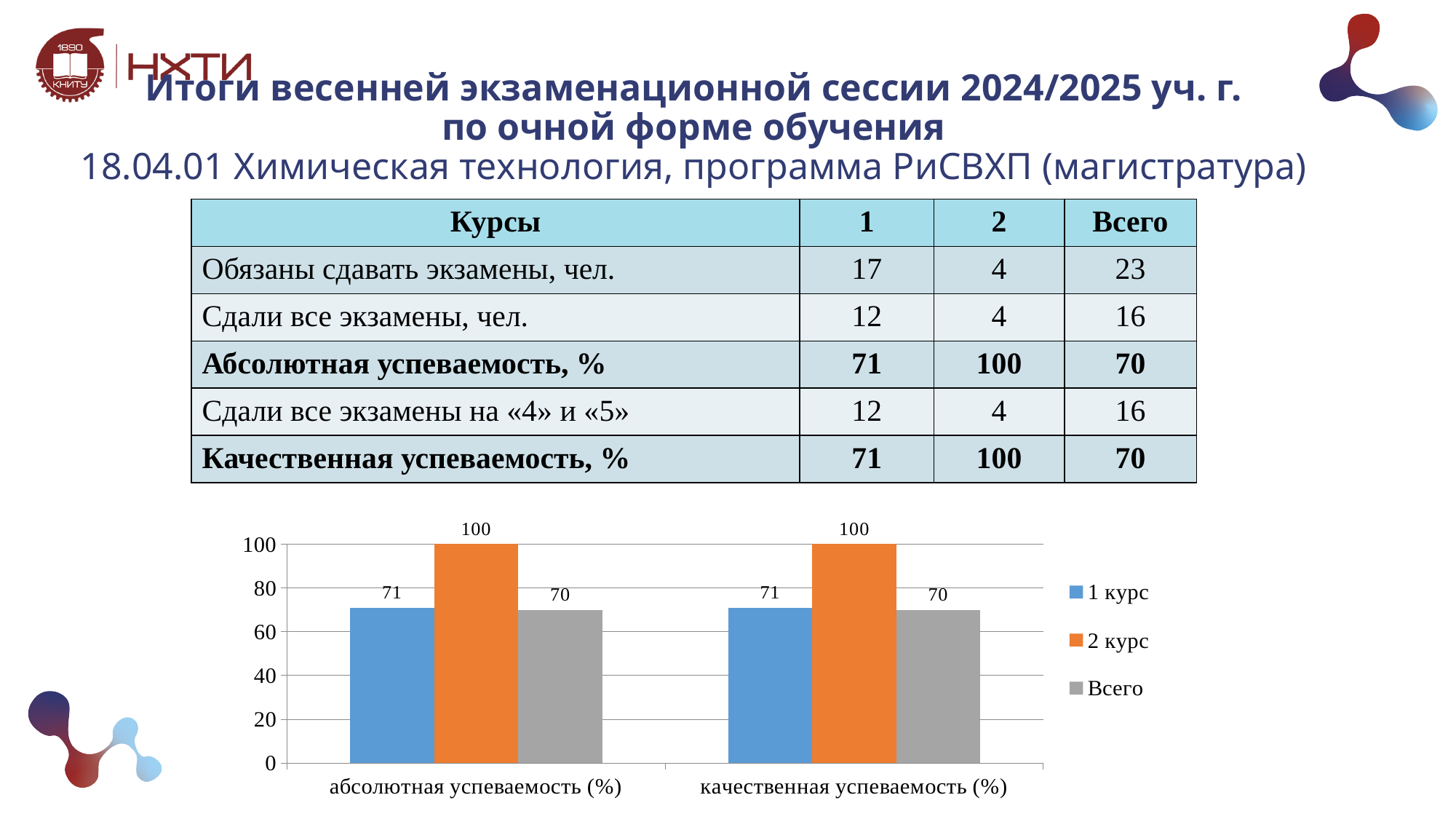
What is the value for 2 курс in the качественная успеваемость (%) category? 100 What is the value for Всего in the абсолютная успеваемость (%) category? 70 What kind of chart is shown on the slide? bar chart What is the difference between the 2 курс and 1 курс values in the абсолютная успеваемость (%) category? 29 Is the value for 1 курс in the абсолютная успеваемость (%) category greater or less than 80? less Which is larger in the качественная успеваемость (%) category: the value for 1 курс or the value for Всего? 1 курс How many categories are shown on the x axis of the chart? 2 What is the value for 1 курс in the абсолютная успеваемость (%) category? 71 Which series has the lowest value in the абсолютная успеваемость (%) category? Всего How many series does the chart legend list? 3 Which series has the highest value in the качественная успеваемость (%) category? 2 курс What colour are the bars for the 2 курс series? orange